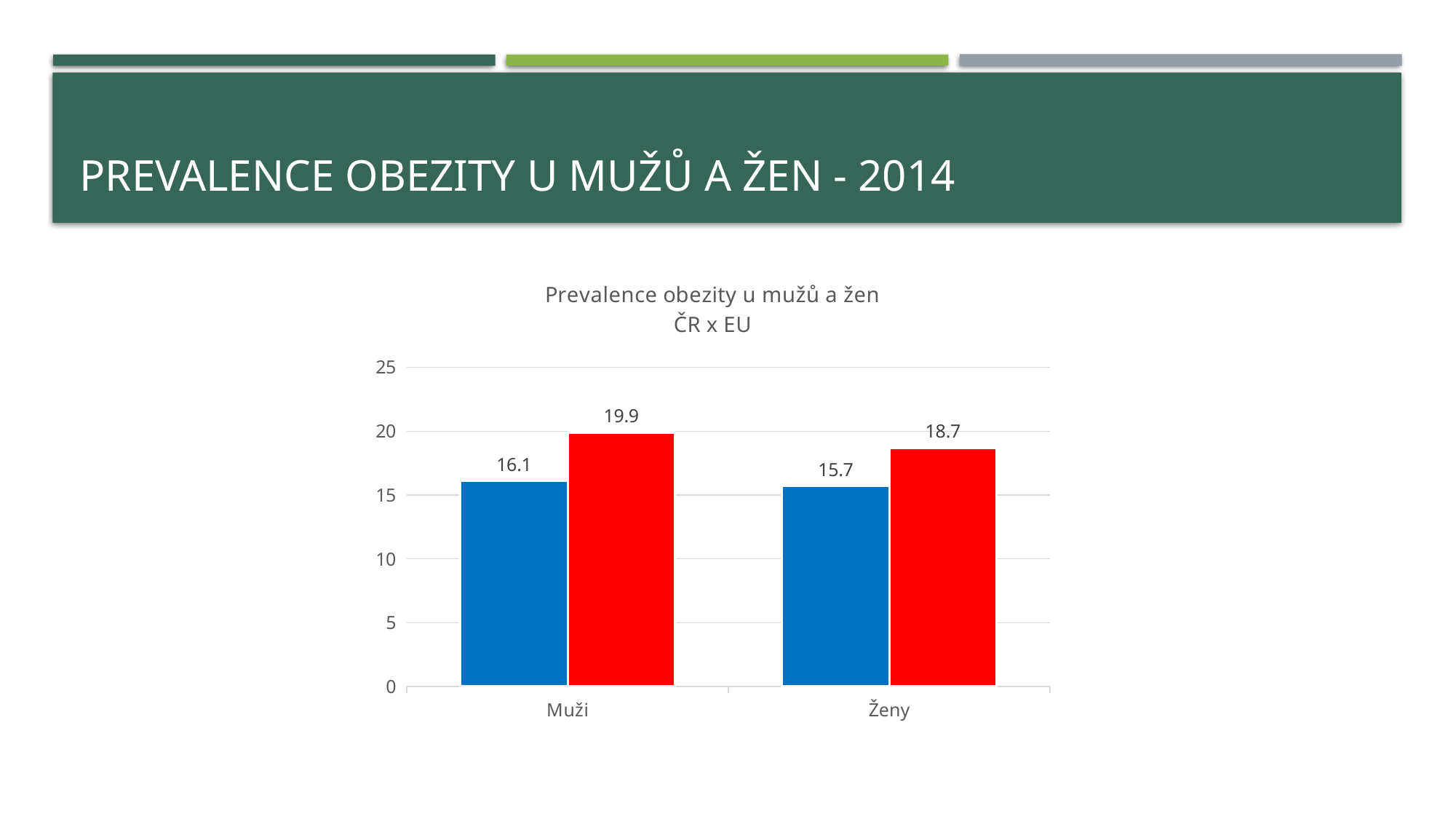
Which is larger, the blue bar for Muži or the blue bar for Ženy? The blue bar for Muži How many categories are shown on the x axis? 2 Which bar has the highest value in the chart? The red bar for Muži (19.9) What is the value of the blue bar for Ženy? 15.7 What is the difference between the red bar for Muži and the red bar for Ženy? 1.2 Is the value of the red bar for Ženy greater or less than 20? less What is the value of the red bar for Ženy? 18.7 What is the value of the red bar for Muži? 19.9 What is the value of the blue bar for Muži? 16.1 What is the difference between the red and blue bars for Muži? 3.8 Which bar has the lowest value in the chart? The blue bar for Ženy (15.7) What type of chart is shown on the slide? Bar chart